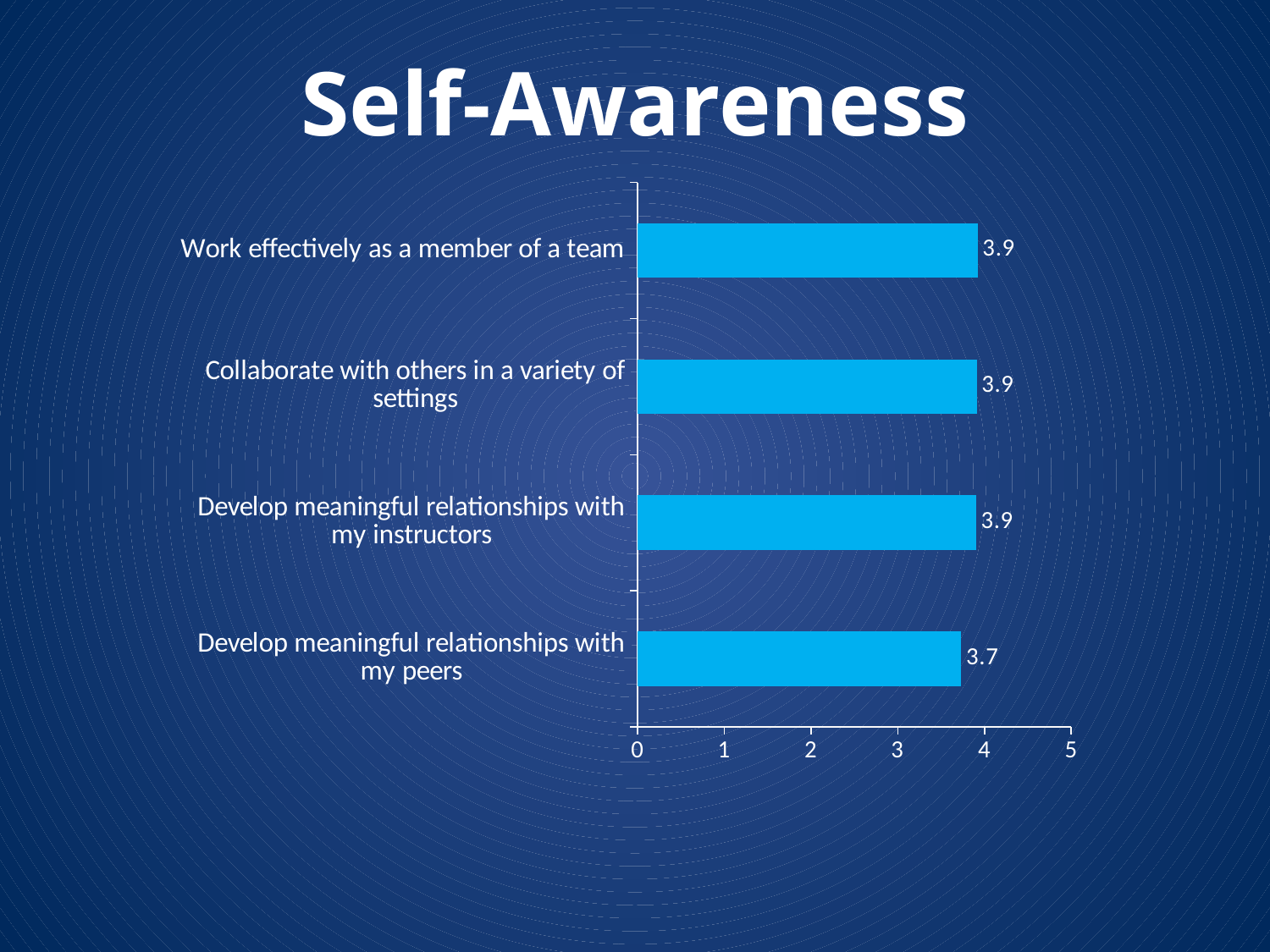
What is the value for "Develop meaningful relationships with my instructors"? 3.9 What is the value for "Collaborate with others in a variety of settings"? 3.9 How many categories are shown in the chart? 4 What is the maximum value shown on the horizontal axis? 5 What kind of chart is shown on the slide? bar chart Which is larger: the value for "Develop meaningful relationships with my instructors" or "Develop meaningful relationships with my peers"? Develop meaningful relationships with my instructors Which category has the lowest value? Develop meaningful relationships with my peers Is the value for "Develop meaningful relationships with my peers" greater or less than 4? less What is the value for "Work effectively as a member of a team"? 3.9 What is the value for "Develop meaningful relationships with my peers"? 3.7 What is the difference between the values for "Work effectively as a member of a team" and "Develop meaningful relationships with my peers"? 0.2 What is the title of the slide? Self-Awareness